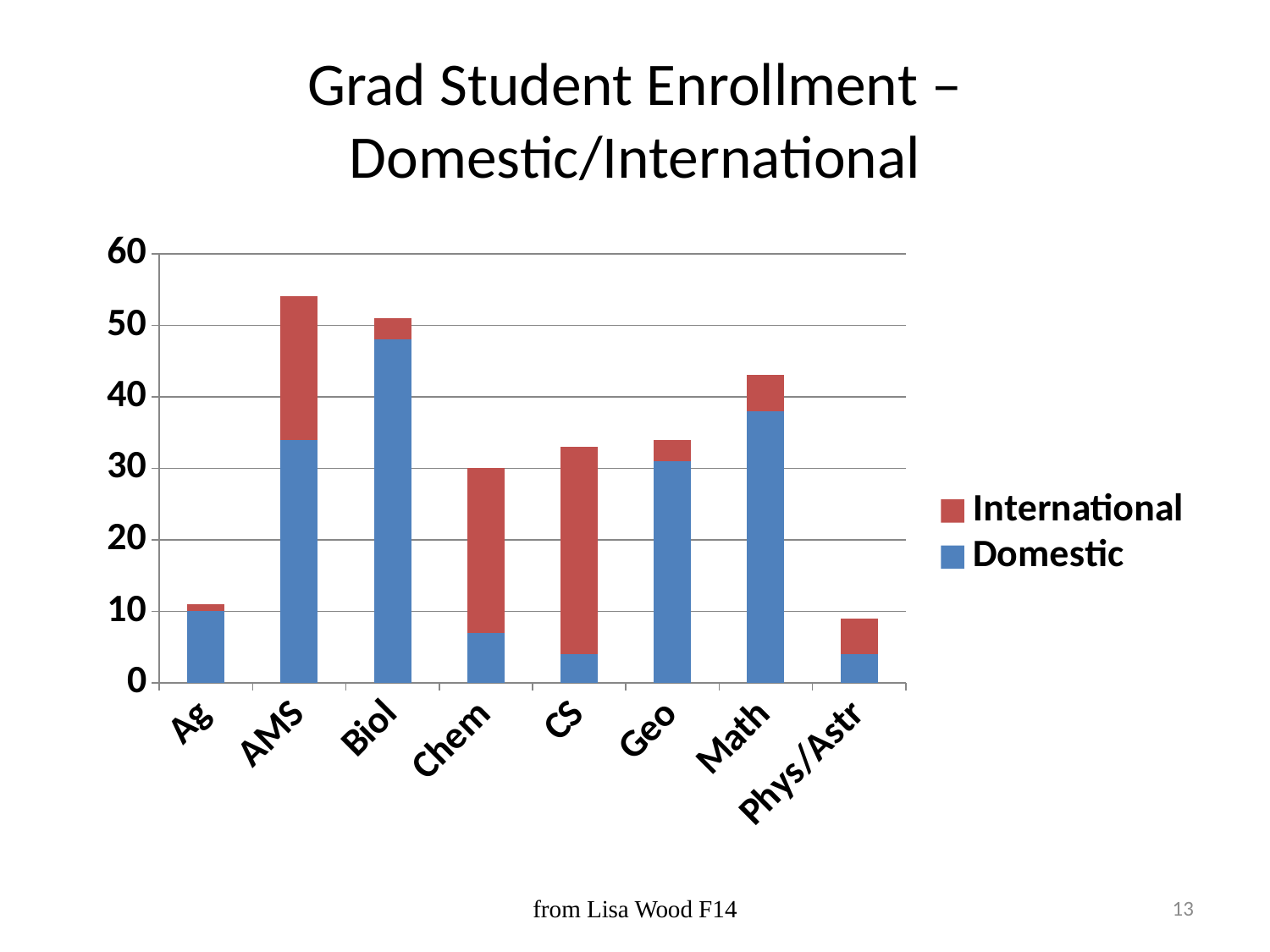
How many series does the legend list? 2 Which department has the largest Domestic segment? Biol Which department has the tallest total bar? AMS Which has the larger total bar, Math or Chem? Math Is the Domestic value for Math greater or less than 30? greater How many departments (categories) are shown on the x axis? 8 What kind of chart is shown on the slide? stacked bar chart Is the total bar for AMS greater or less than 50? greater Which department has the largest International segment? CS Which colour represents the International series in the legend? red Is the Domestic value for Chem greater or less than 10? less